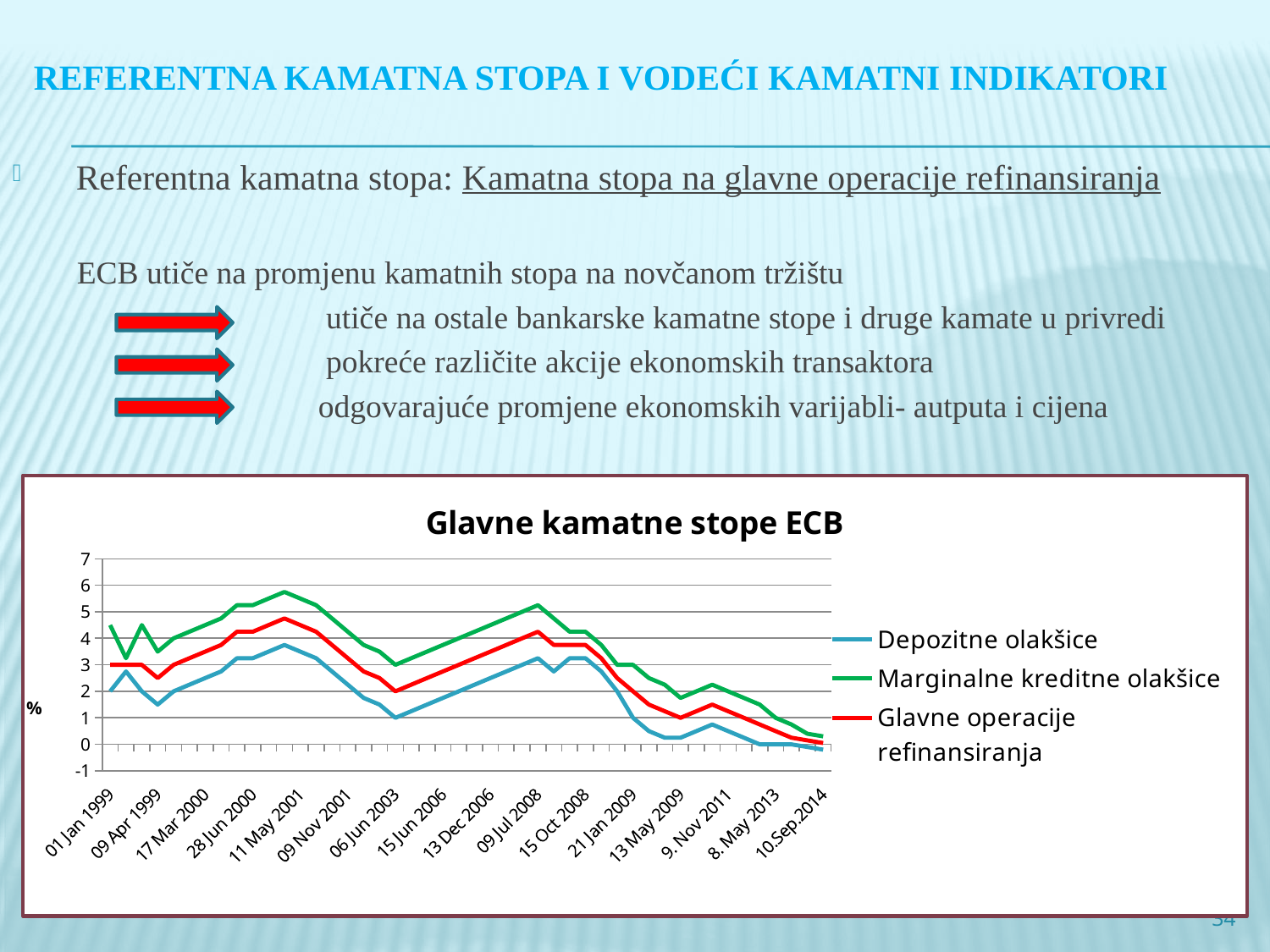
What is the value of Glavne operacije refinansiranja on 01 Jan 1999? 3 What is the value of Depozitne olakšice on 06 Jun 2003? 1 Is the value for Marginalne kreditne olakšice on 11 May 2001 greater or less than 5? greater What kind of chart is shown on the slide? line chart Which series has the highest values across the whole period? Marginalne kreditne olakšice Do the interest rates rise or fall between 15 Oct 2008 and 10 Sep 2014? fall What is the value of Marginalne kreditne olakšice on 06 Jun 2003? 3 How many series does the chart legend list? 3 Which series is plotted with the green line? Marginalne kreditne olakšice What is the title of the chart? Glavne kamatne stope ECB Which series has the lowest values across the whole period? Depozitne olakšice Is the value for Depozitne olakšice on 10 Sep 2014 greater or less than 1? less